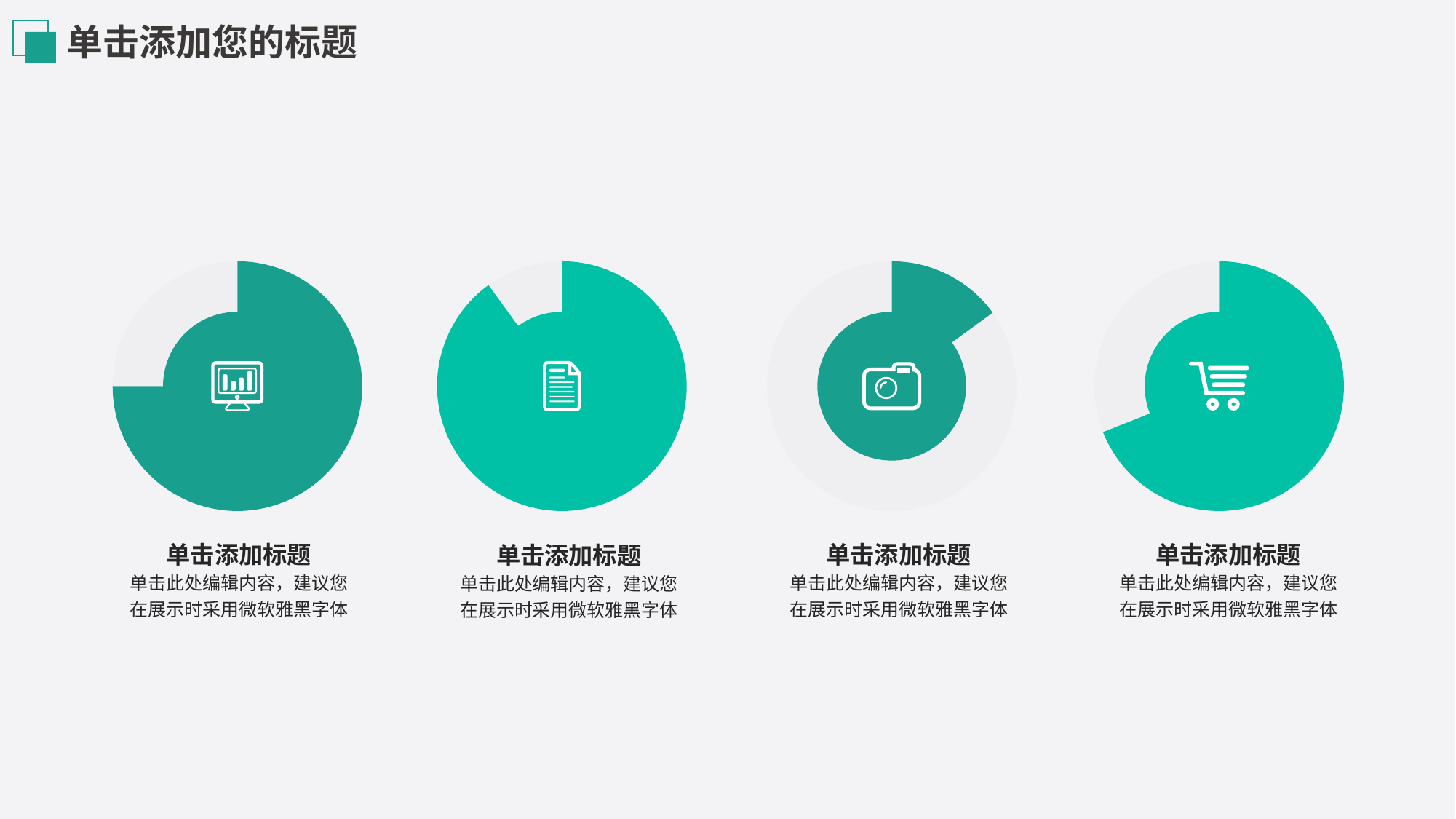
Is the filled portion of the fourth pie chart from the left larger or smaller than that of the second pie chart? smaller How many pie charts are shown on the slide? 4 What kind of chart are the four circular graphics on the slide? pie chart What icon is shown in the centre of the third pie chart from the left? a camera Which pie chart, counted from the left, has the largest filled (coloured) portion? the second Which pie chart, counted from the left, has the smallest filled (coloured) portion? the third Is the filled portion of the first pie chart from the left larger or smaller than that of the third pie chart? larger What icon is shown in the centre of the fourth pie chart from the left? a shopping cart